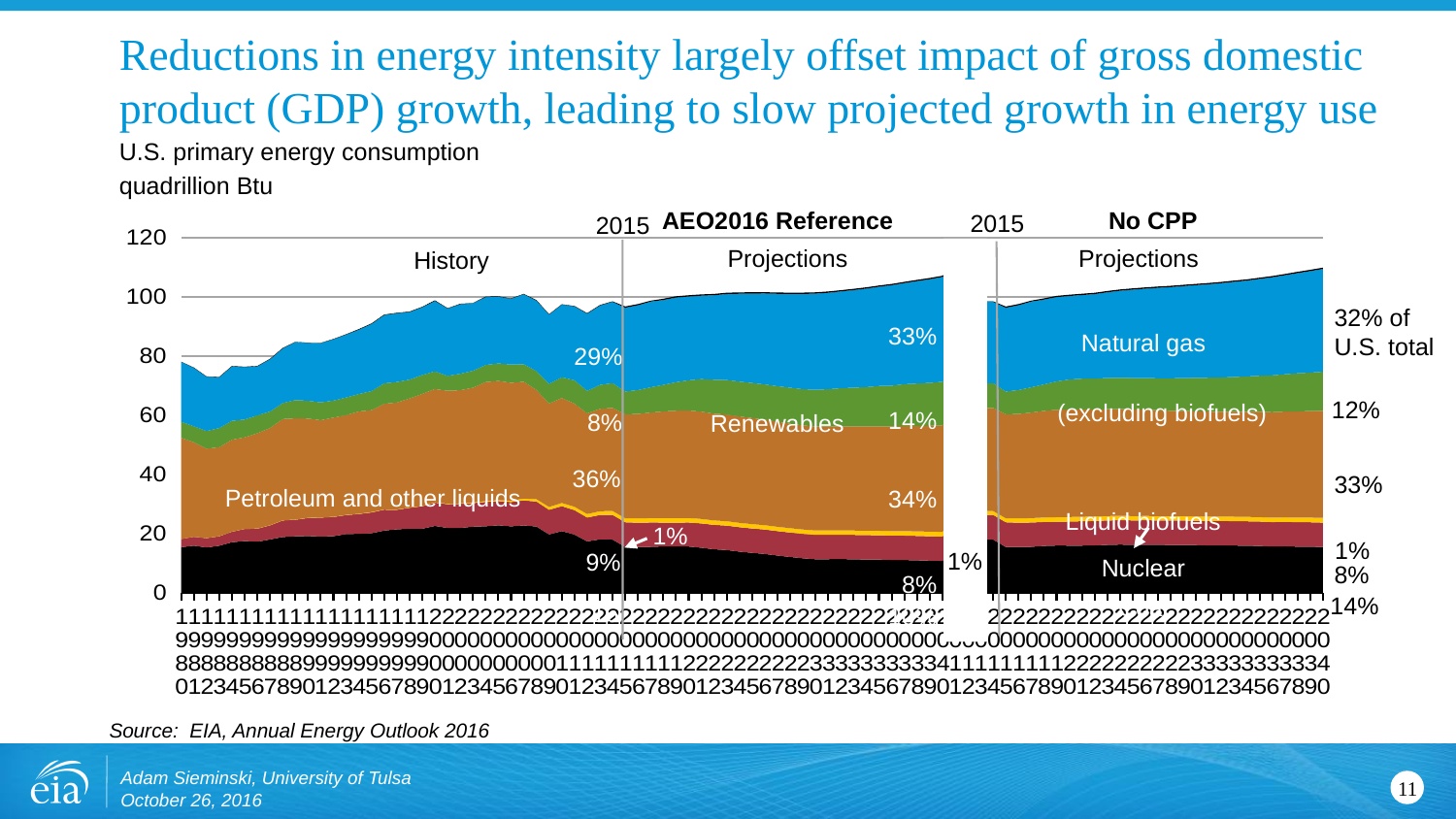
In the AEO2016 Reference chart, what share of U.S. primary energy consumption does natural gas account for in 2015? 29% In the AEO2016 Reference chart, is total U.S. primary energy consumption at the end of the projections greater or less than 100 quadrillion Btu? greater In the AEO2016 Reference chart, what share does petroleum and other liquids hold in 2015? 36% In the No CPP chart, what share of the U.S. total does natural gas reach at the end of the projections? 32% What kind of chart is used on this slide to show U.S. primary energy consumption? Stacked area chart In the AEO2016 Reference chart, what is the renewables share in 2015? 8% What unit is used on the y-axis of the charts? quadrillion Btu Which case shows a larger renewables share at the end of the projections, AEO2016 Reference or No CPP? AEO2016 Reference In the No CPP chart, what share does petroleum and other liquids hold at the end of the projections? 33% In the AEO2016 Reference chart, what share does natural gas reach at the end of the projection period? 33% In the AEO2016 Reference chart, does total primary energy consumption rise or fall over the projection period? Rise In the AEO2016 Reference chart, by how many percentage points does the renewables share grow from 2015 (8%) to the end of the projections (14%)? 6 percentage points